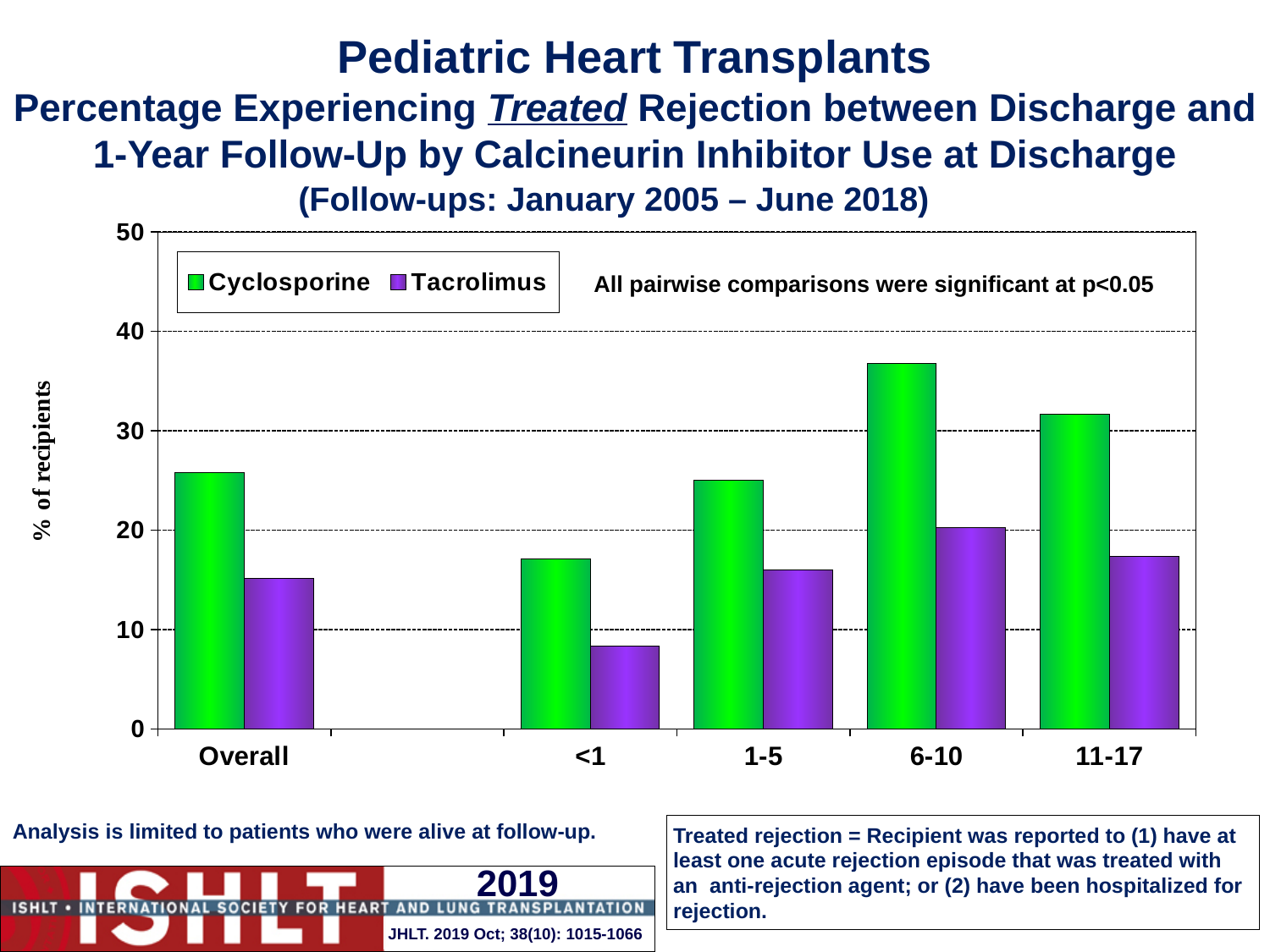
Which category has the lowest Cyclosporine value? <1 How many series does the legend list? 2 For Tacrolimus, which is larger, the value for 6-10 or the value for 11-17? 6-10 Which category has the lowest Tacrolimus value? <1 In the Overall category, which is larger, the Cyclosporine value or the Tacrolimus value? Cyclosporine What is the label on the y axis of the chart? % of recipients Is the Tacrolimus value for the <1 category greater or less than 10? less Is the Cyclosporine value for the Overall category greater or less than 20? greater What kind of chart is shown on the slide? bar chart How many age categories are shown on the x axis? 5 Is the Cyclosporine value for the 6-10 category greater or less than 30? greater Which category has the highest Cyclosporine value? 6-10